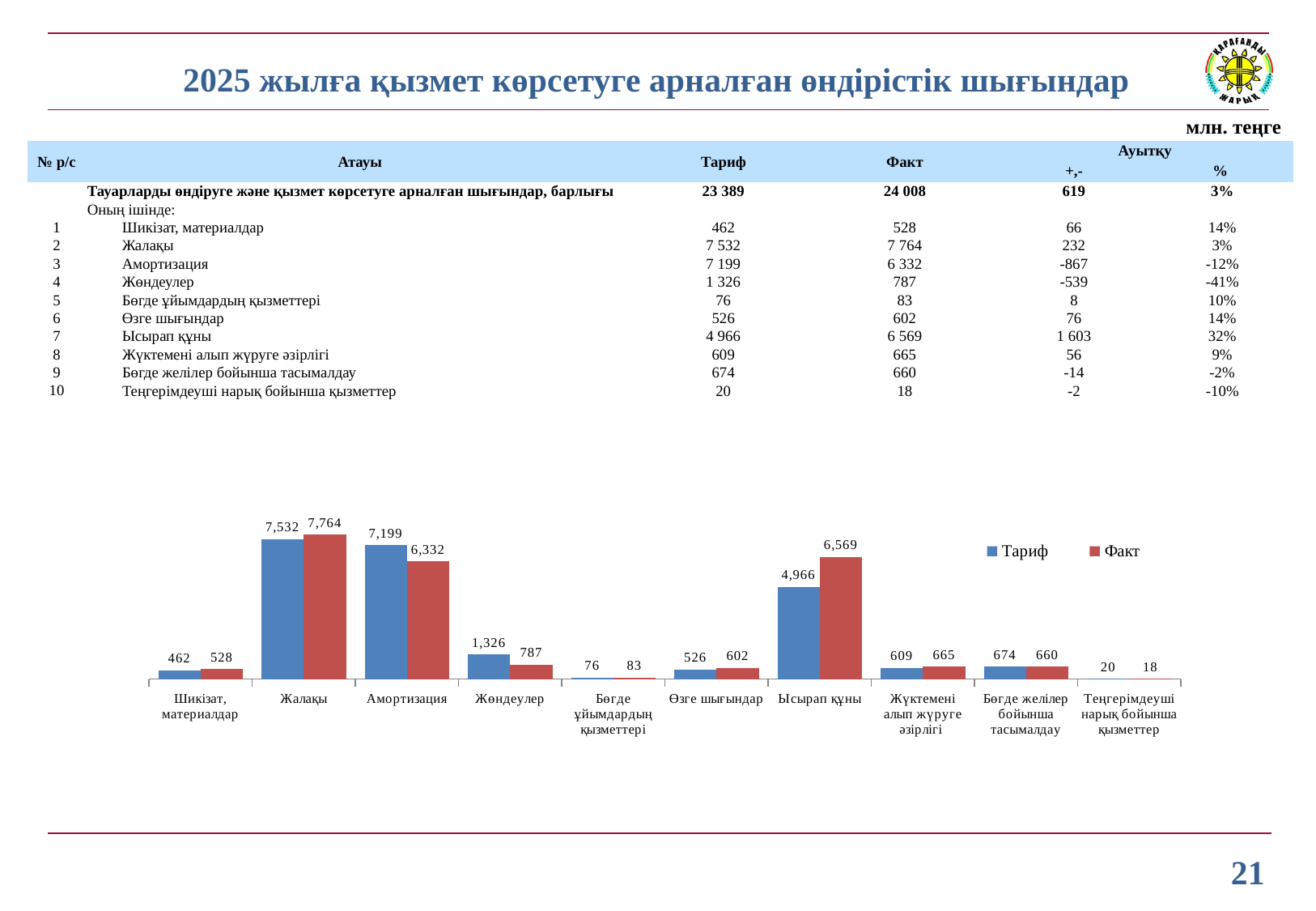
How many categories are shown on the x axis of the chart? 10 What is the difference between the Факт and Тариф values for Ысырап құны? 1,603 How many series does the chart legend list? 2 What is the Факт value for Ысырап құны in the chart? 6,569 What is the Факт value for Жөндеулер in the chart? 787 What type of chart is shown on the slide? Bar chart Which category has the lowest Тариф value in the chart? Теңгерімдеуші нарық бойынша қызметтер For Жөндеулер, which is larger: the Тариф value or the Факт value? Тариф What is the difference between the Тариф and Факт values for Амортизация? 867 For Шикізат, материалдар, which is larger: the Тариф value or the Факт value? Факт Which category has the highest Факт value in the chart? Жалақы What is the Тариф value for Жалақы in the chart? 7,532